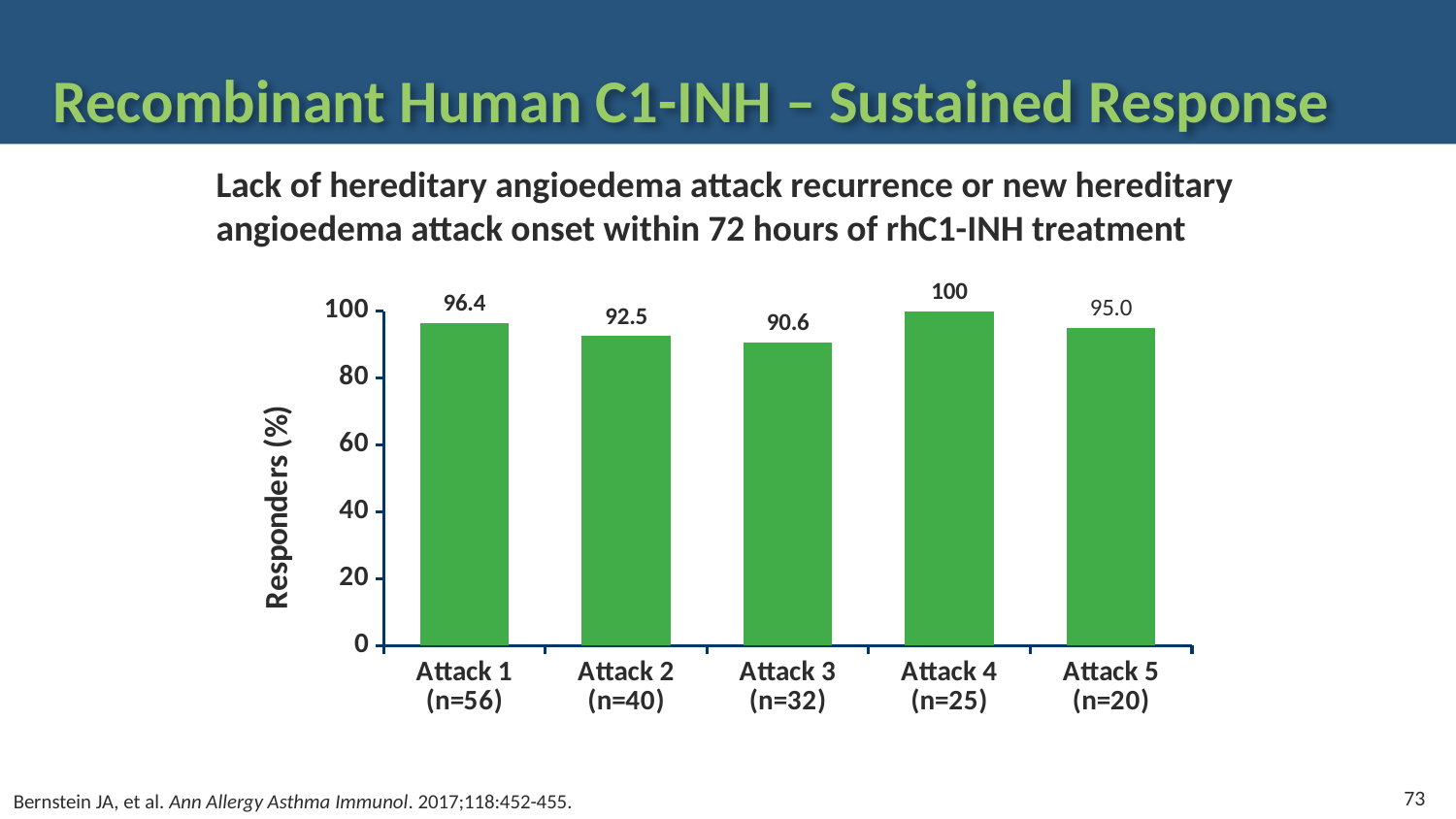
What is the difference between the values for Attack 1 and Attack 2? 3.9 Is the value for Attack 3 greater or less than 80? greater What is the difference between the values for Attack 4 and Attack 3? 9.4 Which attack has the lowest percentage of responders? Attack 3 (n=32) What is the value for Attack 5 (n=20)? 95.0 What is the label of the y axis? Responders (%) What kind of chart is shown on the slide? Bar chart Which is larger, the value for Attack 2 or the value for Attack 5? Attack 5 What is the value for Attack 1 (n=56)? 96.4 How many attack categories are shown on the x axis? 5 Which attack has the highest percentage of responders? Attack 4 (n=25) What is the value for Attack 3 (n=32)? 90.6